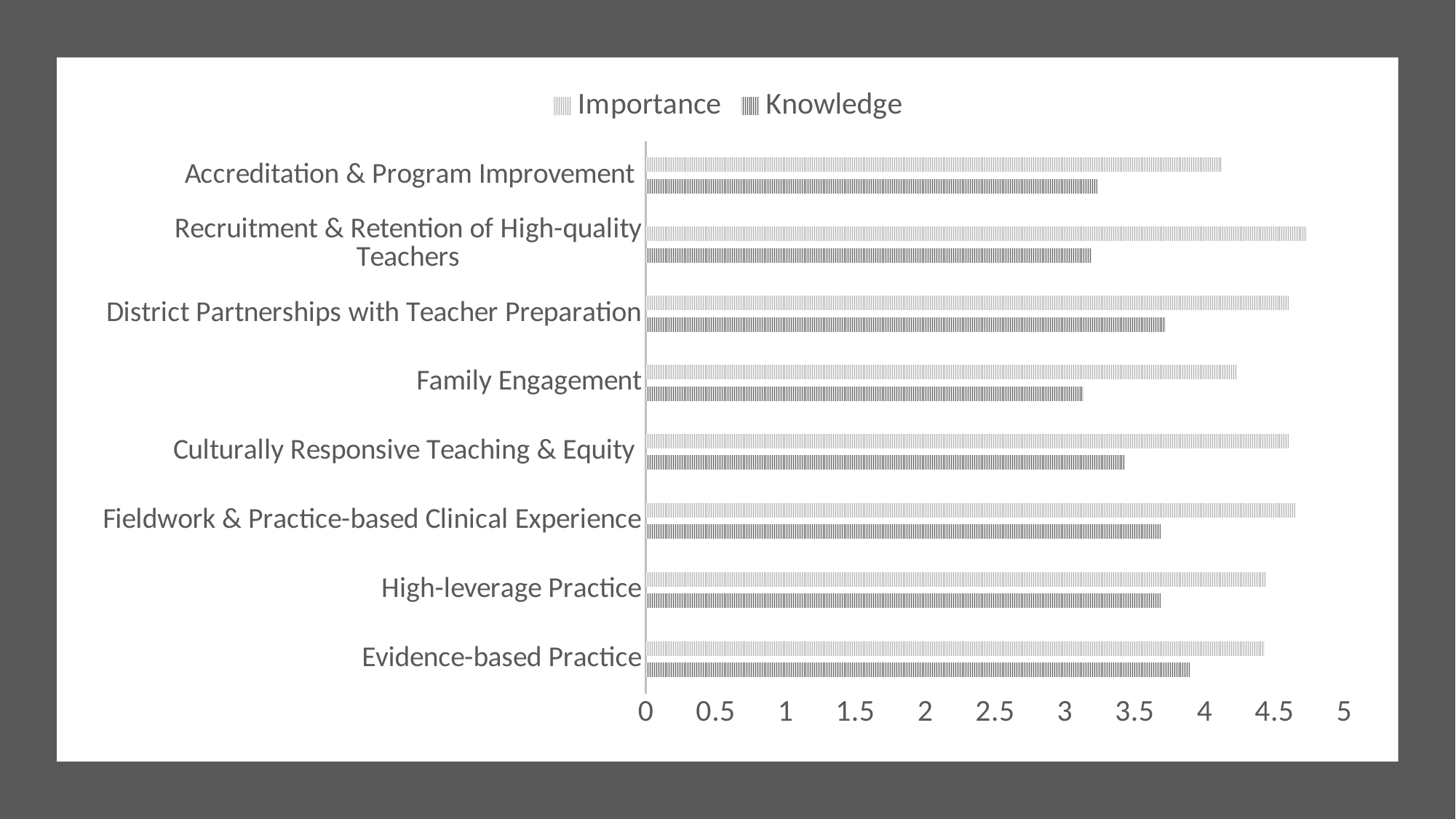
How many categories are plotted on the chart? 8 Is the Importance value for Recruitment & Retention of High-quality Teachers greater or less than 4.5? greater Is the Knowledge value for Accreditation & Program Improvement greater or less than 3.5? less How many series does the legend list? 2 For Culturally Responsive Teaching & Equity, which is larger: the Importance value or the Knowledge value? Importance Is the Knowledge value for Evidence-based Practice greater or less than 3.5? greater Which is larger: the Knowledge value for Evidence-based Practice or the Knowledge value for Accreditation & Program Improvement? Evidence-based Practice What are the two series named in the legend? Importance and Knowledge Which category has the highest Knowledge value? Evidence-based Practice What kind of chart is shown on the slide? bar chart